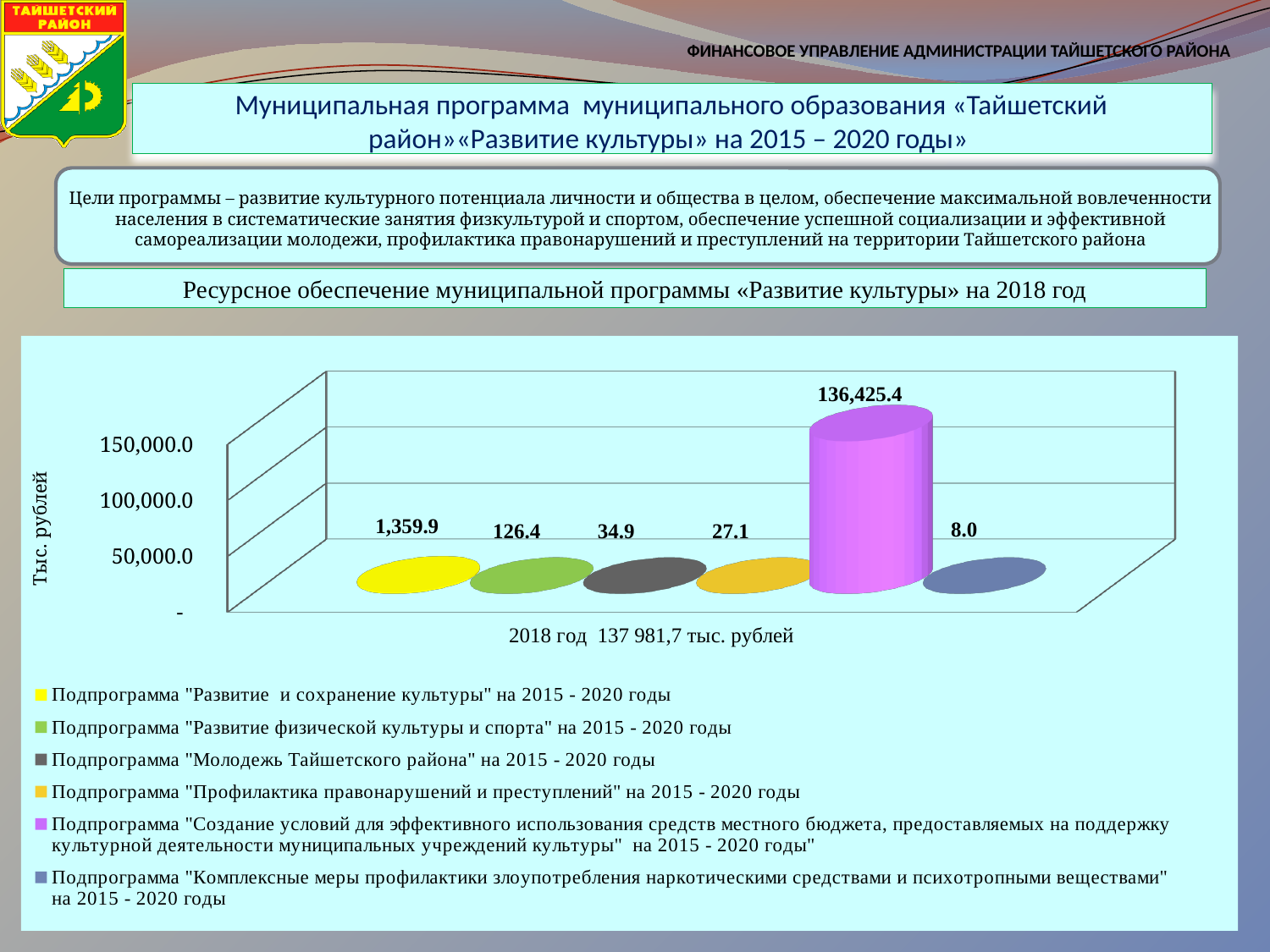
How many series does the legend list? 6 What is the value for the subprogram "Профилактика правонарушений и преступлений" на 2015 - 2020 годы? 27.1 What unit is shown on the vertical axis of the chart? Тыс. рублей What kind of chart is shown on the slide? Bar chart What is the value for the subprogram "Развитие и сохранение культуры" на 2015 - 2020 годы? 1,359.9 What is the value for the subprogram "Молодежь Тайшетского района" на 2015 - 2020 годы? 34.9 Which is larger: the value for "Молодежь Тайшетского района" or the value for "Профилактика правонарушений и преступлений"? Молодежь Тайшетского района Which subprogram has the highest value on the chart? Подпрограмма "Создание условий для эффективного использования средств местного бюджета, предоставляемых на поддержку культурной деятельности муниципальных учреждений культуры" на 2015 - 2020 годы What is the value for the subprogram "Комплексные меры профилактики злоупотребления наркотическими средствами и психотропными веществами" на 2015 - 2020 годы? 8.0 Which subprogram has the lowest value on the chart? Подпрограмма "Комплексные меры профилактики злоупотребления наркотическими средствами и психотропными веществами" на 2015 - 2020 годы What is the value for the subprogram "Развитие физической культуры и спорта" на 2015 - 2020 годы? 126.4 What is the difference between the values for "Развитие физической культуры и спорта" and "Молодежь Тайшетского района"? 91.5